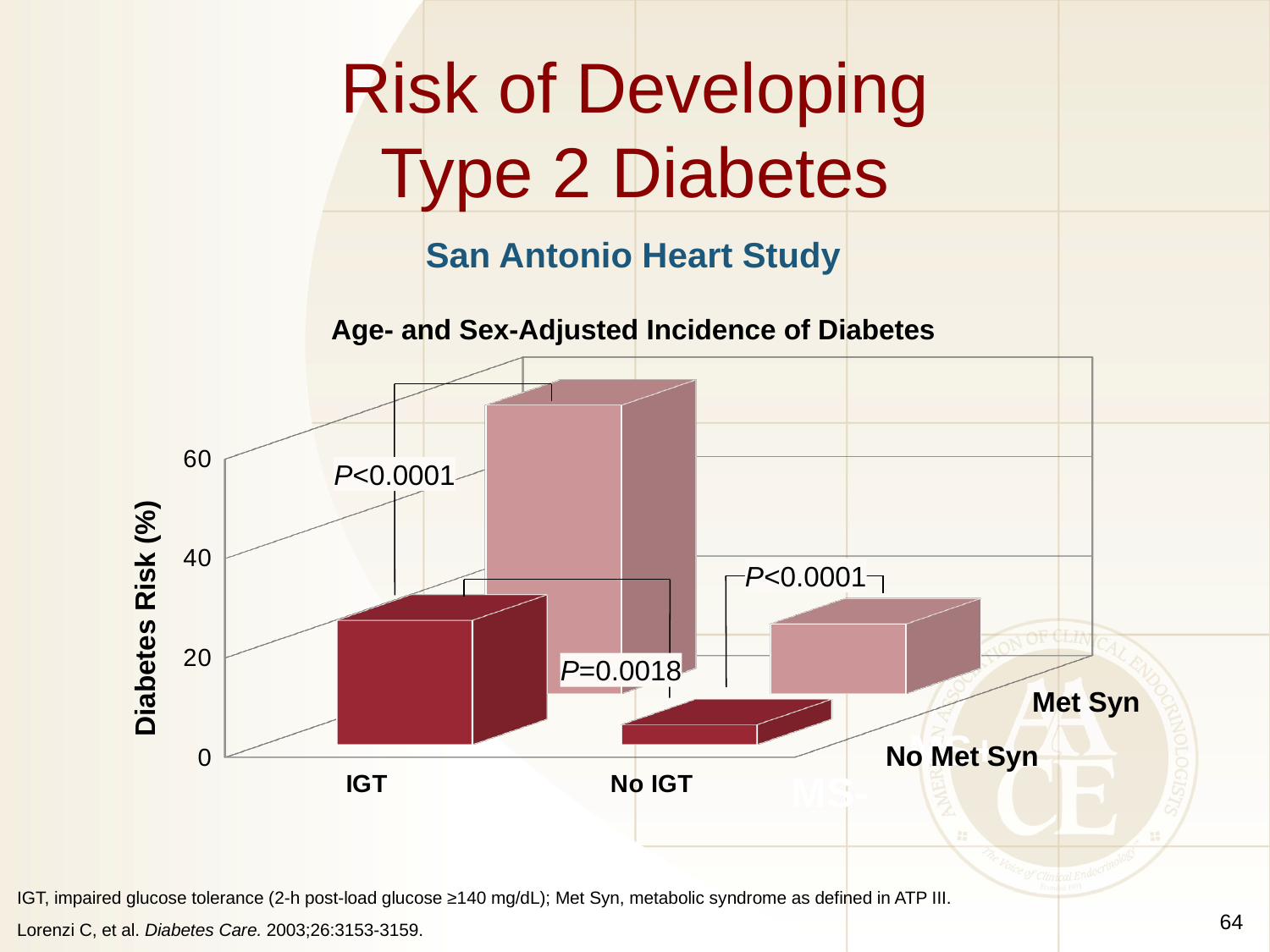
What is the label of the vertical axis of the chart? Diabetes Risk (%) Is the diabetes risk for IGT with Met Syn greater or less than 40? greater How many categories are shown on the x axis of the chart? 2 Which bar is the highest in the chart? IGT, Met Syn Within the Met Syn series, which category has the larger diabetes risk, IGT or No IGT? IGT Which bar is the lowest in the chart? No IGT, No Met Syn Is the diabetes risk for IGT with No Met Syn greater or less than 40? less Is the diabetes risk for No IGT with No Met Syn greater or less than 20? less Within the No Met Syn series, which category has the larger diabetes risk, IGT or No IGT? IGT How many series (Met Syn groups) does the chart show? 2 What is the title of the chart? Age- and Sex-Adjusted Incidence of Diabetes What kind of chart is shown on the slide? bar chart